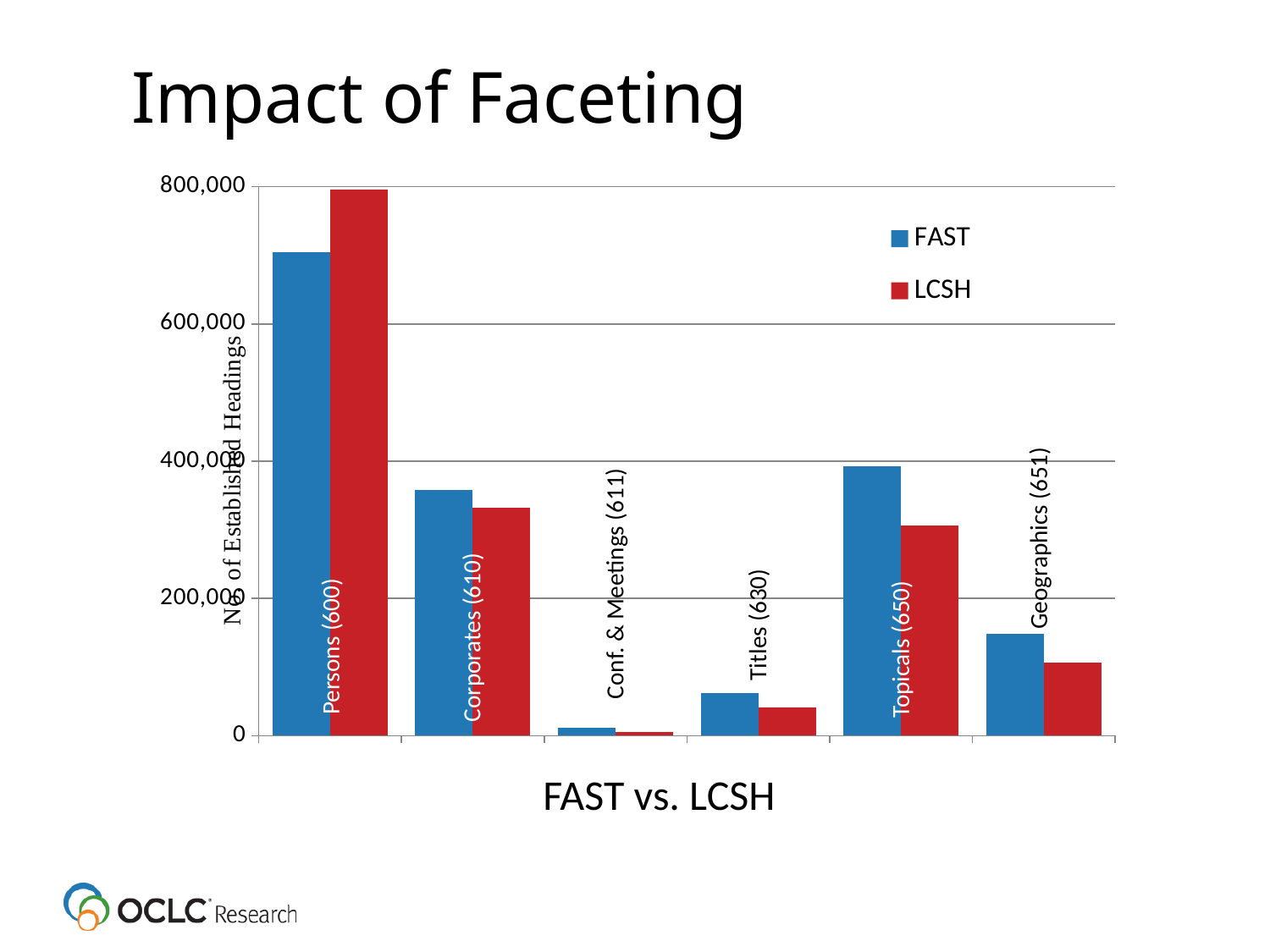
Is the FAST value for Geographics (651) greater or less than 200,000? less For Topicals (650), which is larger, the FAST value or the LCSH value? FAST Is the LCSH value for Persons (600) greater or less than 600,000? greater How many categories are shown on the x axis? 6 Which category has the highest FAST value? Persons (600) What is the label of the y axis? No. of Established Headings For Persons (600), which is larger, the FAST value or the LCSH value? LCSH Which category has the lowest LCSH value? Conf. & Meetings (611) How many series does the legend list? 2 What kind of chart is shown on the slide? bar chart What colour are the LCSH bars? red